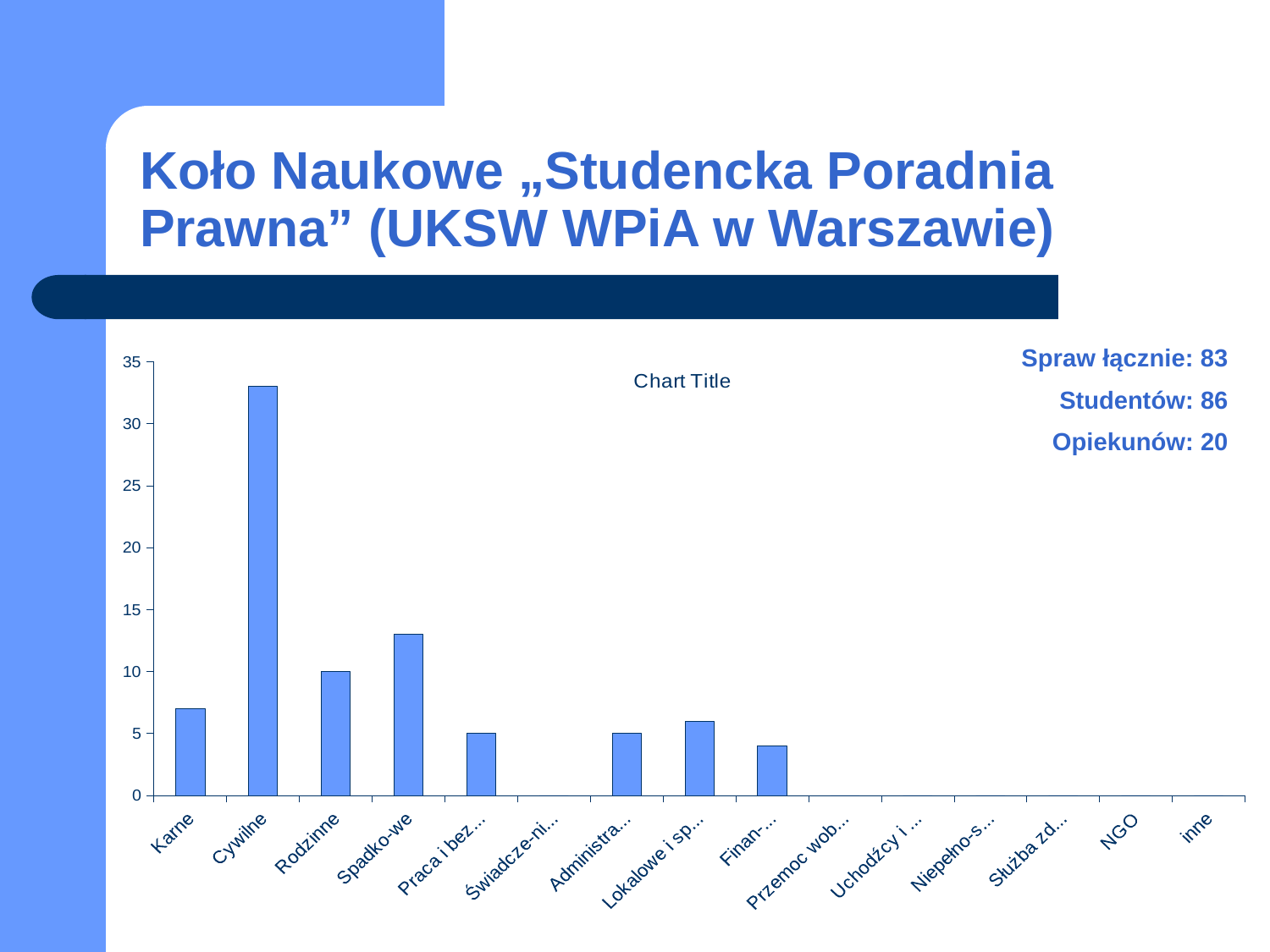
Is the value for Spadko-we greater or less than 10? greater Which category has the highest value in the chart? Cywilne How many categories are shown on the x axis of the chart? 15 What kind of chart is shown on the slide? bar chart Which has the larger value, Karne or Rodzinne? Rodzinne Is the value for Karne greater or less than 5? greater Is the value for Karne greater or less than 10? less What is the title shown on the chart? Chart Title Which has the larger value, Spadko-we or Rodzinne? Spadko-we